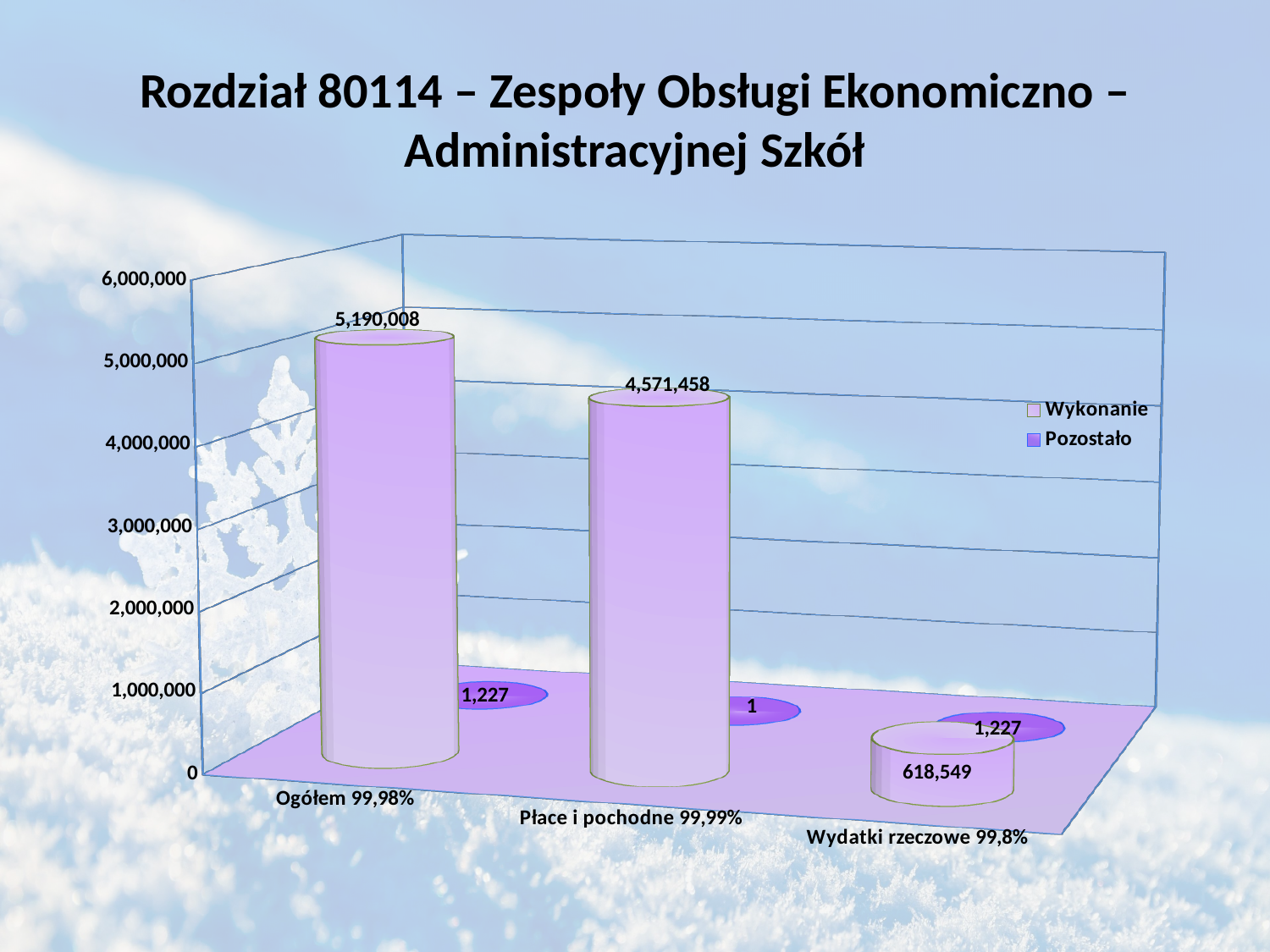
How many categories are shown on the x axis? 3 What is the Pozostało value for Płace i pochodne 99,99%? 1 What is the Pozostało value for Wydatki rzeczowe 99,8%? 1,227 Which category has the lowest Wykonanie value? Wydatki rzeczowe 99,8% Is the Wykonanie value for Płace i pochodne 99,99% greater or less than 4,000,000? greater What is the Wykonanie value for Płace i pochodne 99,99%? 4,571,458 How many series does the legend list? 2 What is the difference between the Wykonanie values for Ogółem 99,98% and Płace i pochodne 99,99%? 618,550 What is the Wykonanie value for Ogółem 99,98%? 5,190,008 What is the Wykonanie value for Wydatki rzeczowe 99,8%? 618,549 What kind of chart is shown on the slide? bar chart Which category has the highest Wykonanie value? Ogółem 99,98%